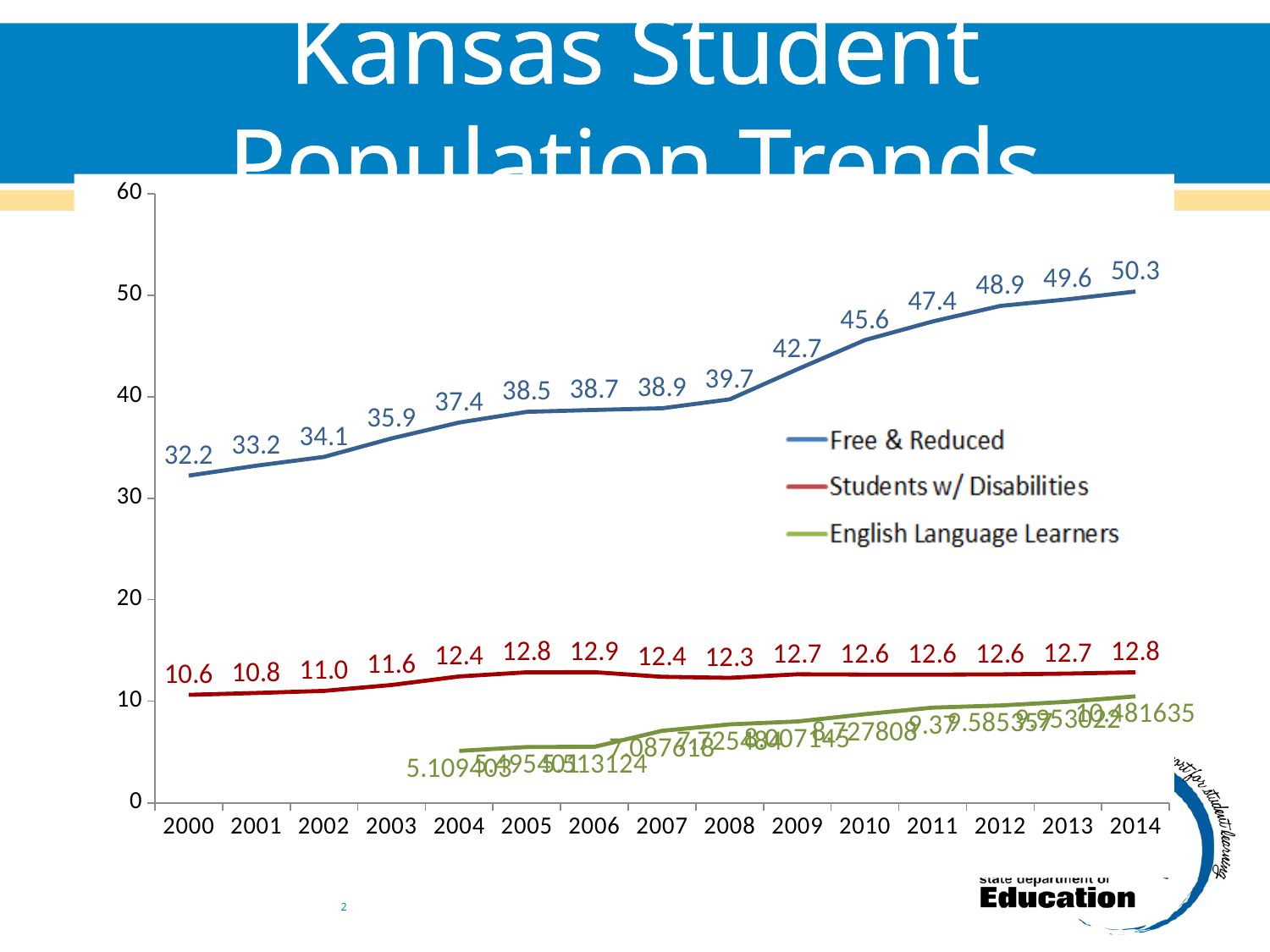
What kind of chart is shown on the slide? line chart How many years are shown on the x axis? 15 In 2009, which is larger: Free & Reduced or Students w/ Disabilities? Free & Reduced By how much did the Free & Reduced value increase from 2000 to 2014? 18.1 What is the Students w/ Disabilities value for 2006? 12.9 What is the Free & Reduced value for 2014? 50.3 Is the English Language Learners value for 2004 greater or less than 10? less How many series does the legend list? 3 In which year is the Free & Reduced series highest? 2014 What is the Free & Reduced value for 2000? 32.2 In which year is the Students w/ Disabilities series lowest? 2000 Does the Free & Reduced series rise or fall from 2000 to 2014? rises